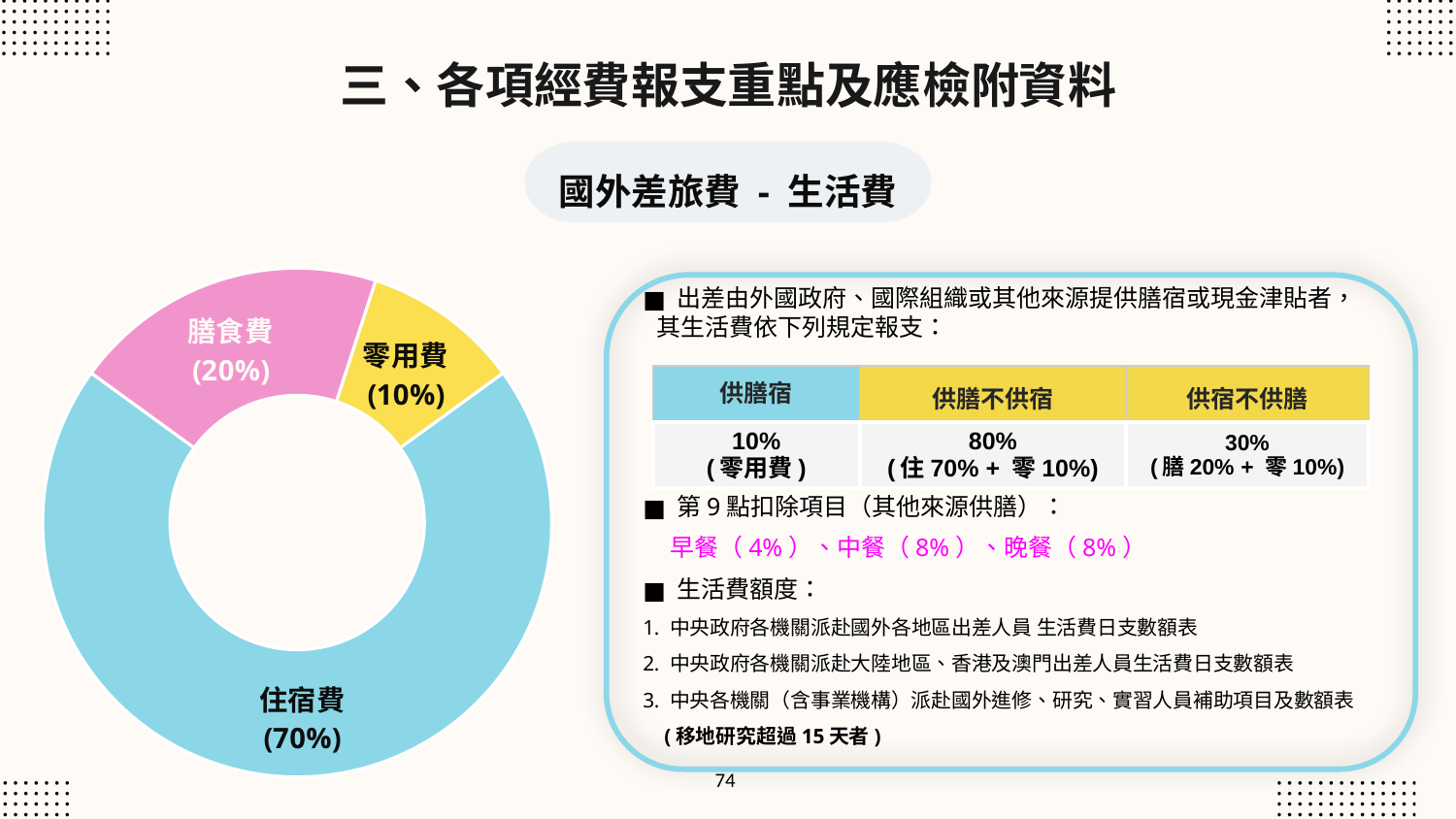
Which category has the largest slice in the donut chart? 住宿費 Which is larger in the donut chart, 膳食費 or 零用費? 膳食費 Which category has the smallest slice in the donut chart? 零用費 What colour is the 膳食費 slice in the donut chart? Pink What colour is the 住宿費 slice in the donut chart? Light blue What share of the donut chart is 膳食費? 20% What share of the donut chart is 住宿費? 70% What kind of chart is shown on the left of the slide? Donut (pie) chart What is the difference in percentage points between 膳食費 and 零用費 in the donut chart? 10 What share of the donut chart is 零用費? 10% How many slices does the donut chart have? 3 What is the difference in percentage points between 住宿費 and 膳食費 in the donut chart? 50